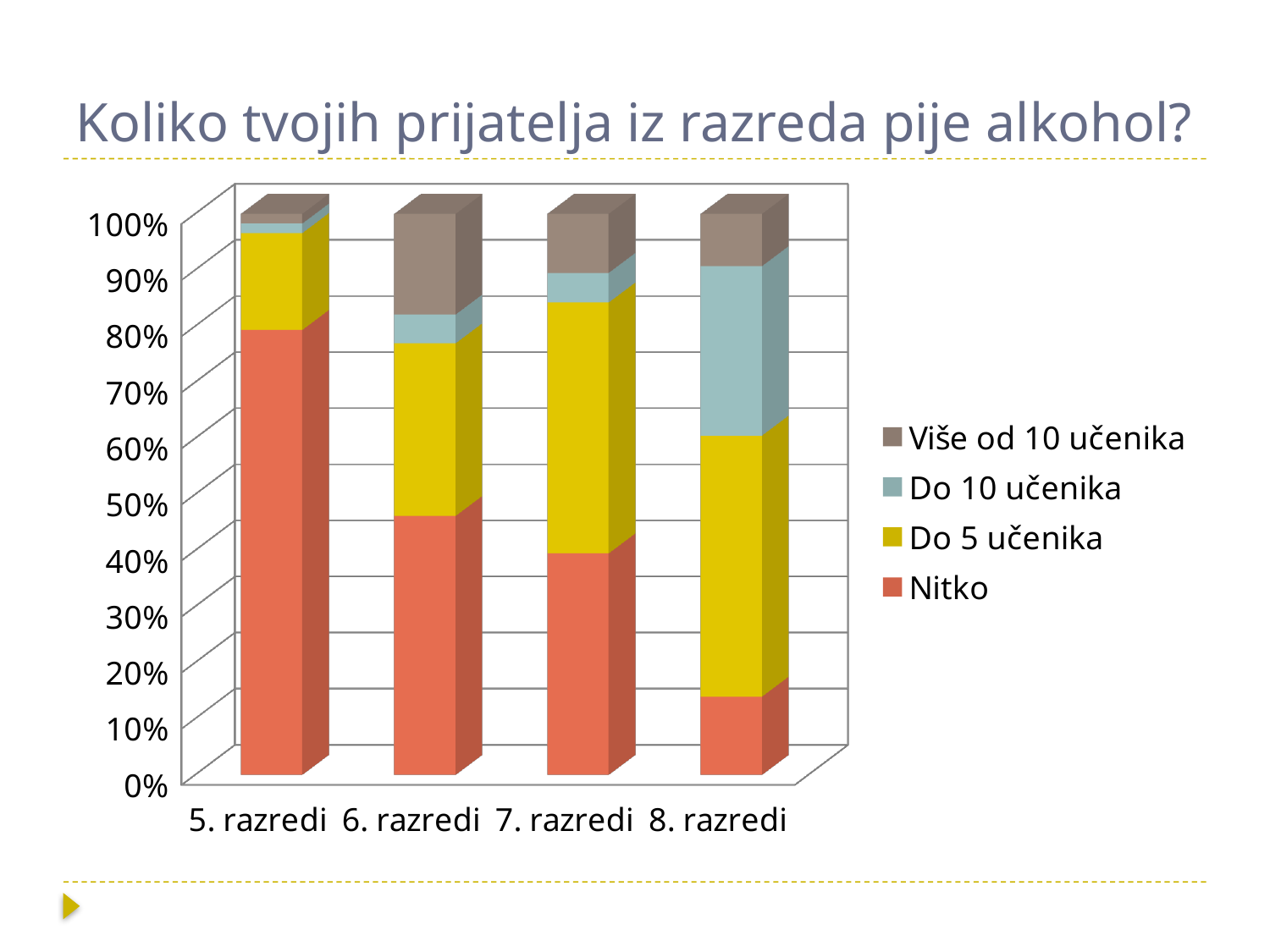
Which grade has the largest share for 'Nitko'? 5. razredi How many series does the legend list? 4 Which grade has the smallest share for 'Nitko'? 8. razredi What kind of chart is shown on the slide? Stacked bar chart What is the title of the chart? Koliko tvojih prijatelja iz razreda pije alkohol? Is the share for 'Nitko' in 5. razredi greater or less than 70%? greater Which grade has the largest share for 'Više od 10 učenika'? 6. razredi Which is larger: the 'Do 5 učenika' share in 7. razredi or in 5. razredi? 7. razredi Does the share for 'Nitko' rise or fall from 5. razredi to 8. razredi? Fall Which grade has the largest share for 'Do 10 učenika'? 8. razredi How many categories (grades) are shown on the x axis? 4 Is the share for 'Nitko' in 8. razredi greater or less than 20%? less